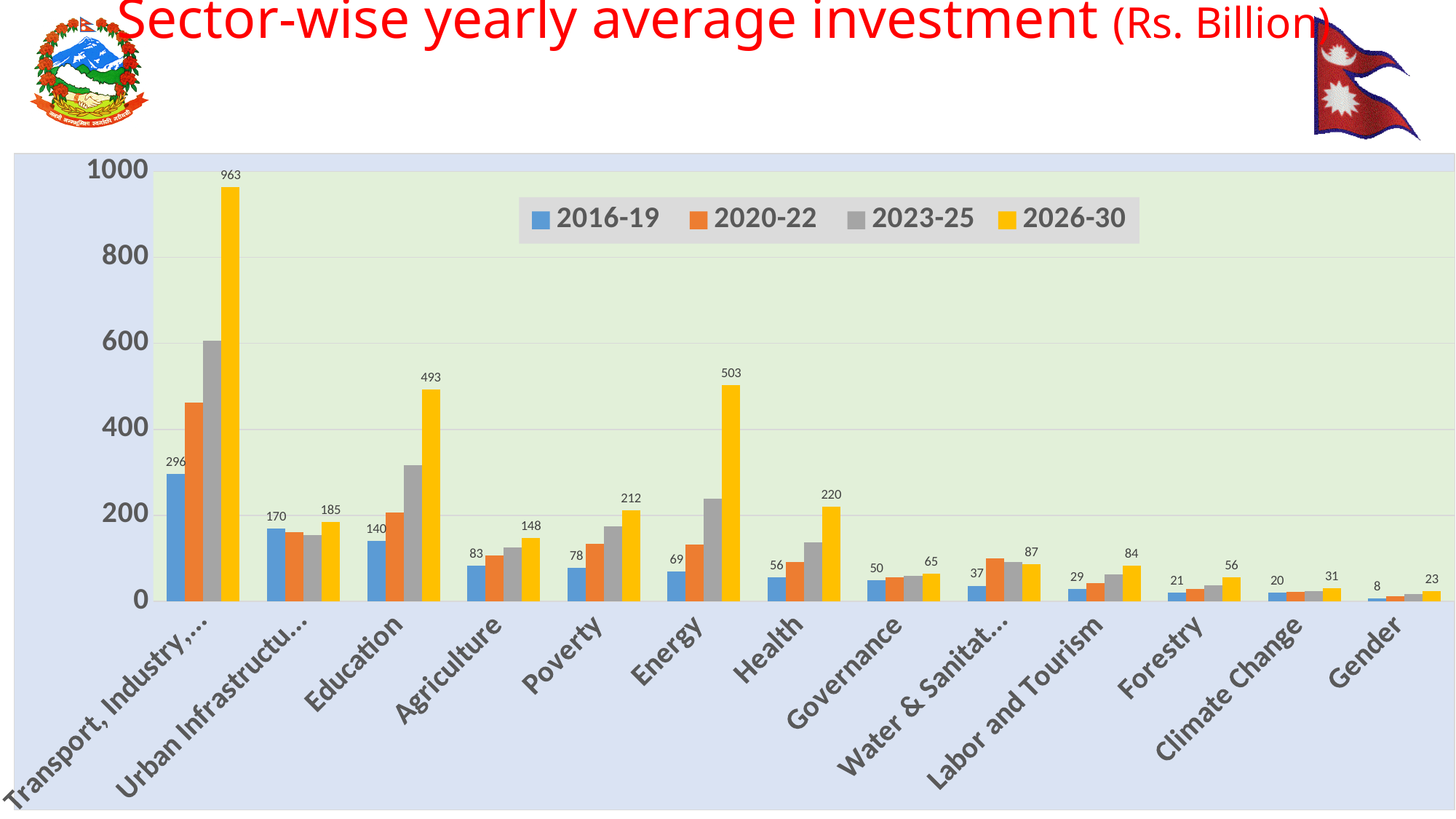
What is the difference between the 2026-30 and 2016-19 values for Energy? 434 What kind of chart is shown on the slide? bar chart How many series does the legend list? 4 Which sector has the lowest value in the 2016-19 series? Gender What is the value for Health in the 2026-30 series? 220 What is the value for Education in the 2026-30 series? 493 Is the 2023-25 value for Education greater or less than 200? greater How many sectors are shown on the x axis? 13 What is the value for Labor and Tourism in the 2026-30 series? 84 Is the 2020-22 value for Poverty greater or less than 200? less What is the value for Energy in the 2016-19 series? 69 Which has the larger 2026-30 value, Poverty or Health? Health